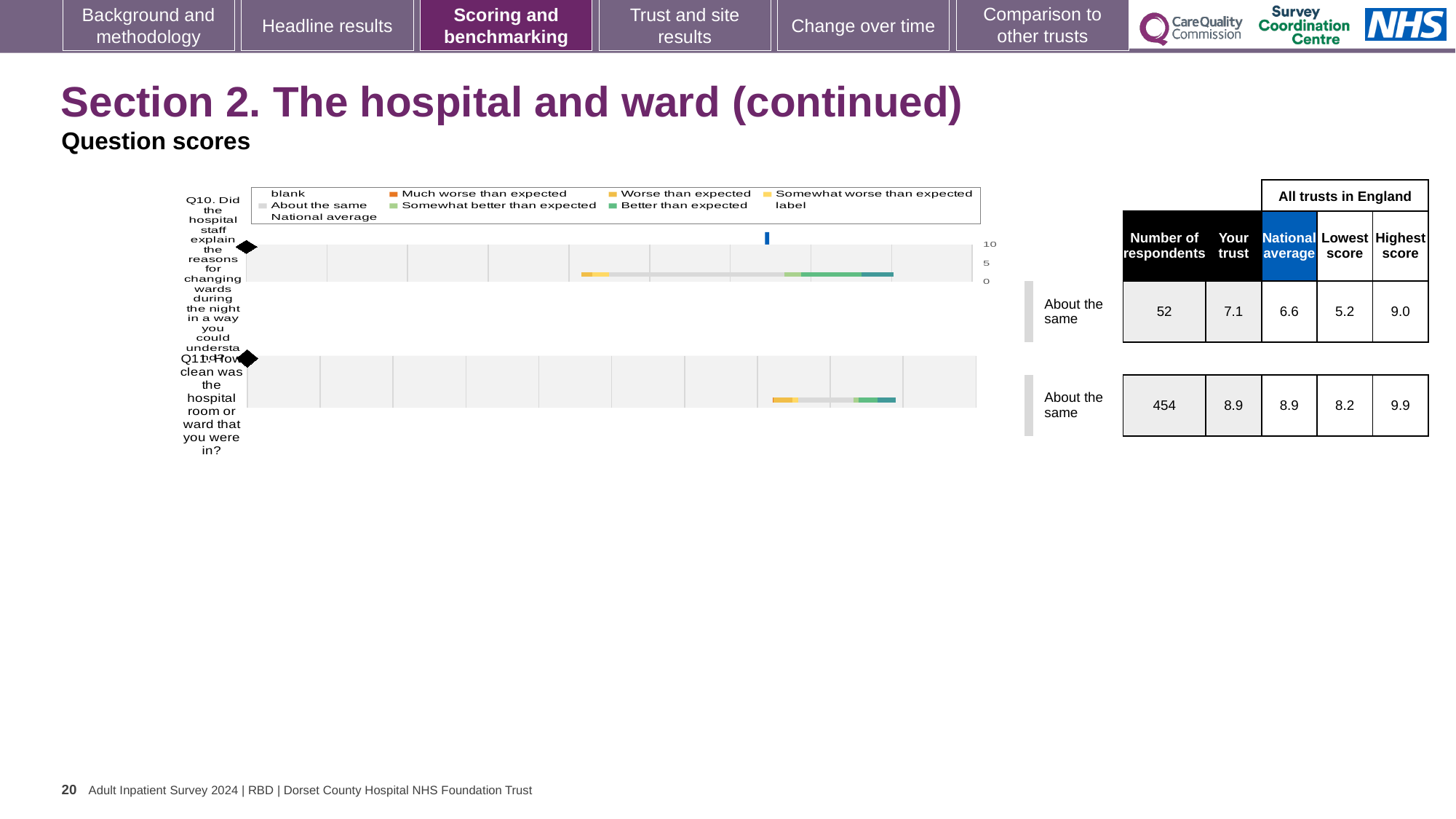
How many respondents answered Q10 (explaining reasons for changing wards during the night)? 52 What is the lowest score among all trusts in England for Q11? 8.2 What is the highest score among all trusts in England for Q10? 9.0 How many survey questions are plotted on this slide? 2 What benchmark category is shown for Q11? About the same What is the 'Your trust' score for Q11 (how clean was the hospital room or ward)? 8.9 What is the national average score for Q10? 6.6 By how much does the trust's score for Q10 exceed the national average for Q10? 0.5 Which question had more respondents, Q10 or Q11? Q11 What is the difference between the highest and lowest scores for Q11? 1.7 Which question has the higher 'Your trust' score, Q10 or Q11? Q11 What type of chart is used to show the question scores? Bar chart